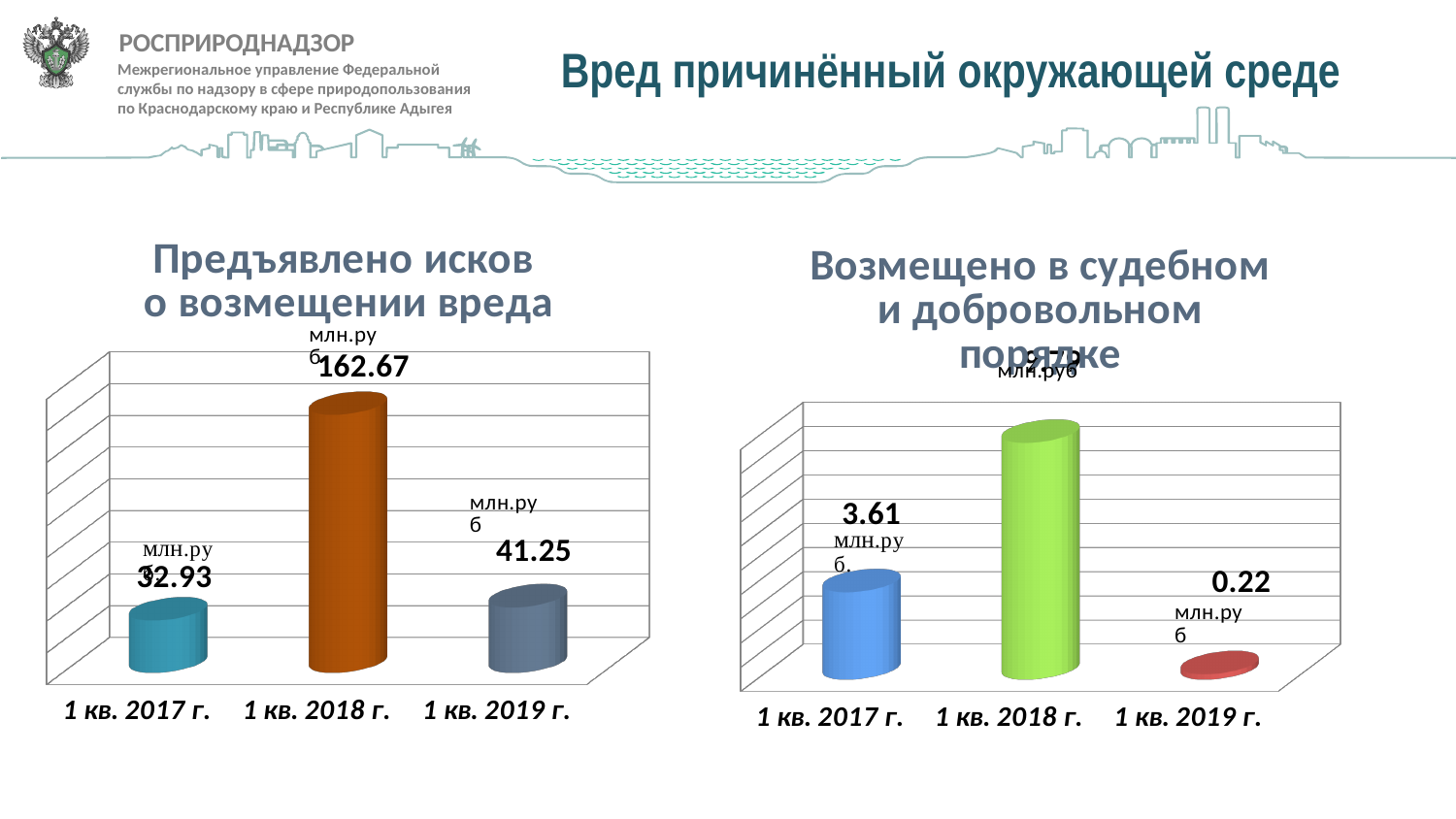
In the chart titled "Предъявлено исков о возмещении вреда", what is the value for 1 кв. 2019 г.? 41.25 In the chart titled "Возмещено в судебном и добровольном порядке", what is the value for 1 кв. 2017 г.? 3.61 In the chart titled "Предъявлено исков о возмещении вреда", which period has the lowest value? 1 кв. 2017 г. What kind of chart is the chart titled "Возмещено в судебном и добровольном порядке"? Bar chart In the chart titled "Предъявлено исков о возмещении вреда", what is the difference between the values for 1 кв. 2018 г. and 1 кв. 2019 г.? 121.42 In the chart titled "Возмещено в судебном и добровольном порядке", what is the value for 1 кв. 2019 г.? 0.22 In the chart titled "Возмещено в судебном и добровольном порядке", which period has the lowest value? 1 кв. 2019 г. In the chart titled "Предъявлено исков о возмещении вреда", what is the value for 1 кв. 2018 г.? 162.67 In the chart titled "Предъявлено исков о возмещении вреда", which is larger: the value for 1 кв. 2017 г. or 1 кв. 2019 г.? 1 кв. 2019 г. In the chart titled "Предъявлено исков о возмещении вреда", what is the value for 1 кв. 2017 г.? 32.93 In the chart titled "Предъявлено исков о возмещении вреда", which period has the highest value? 1 кв. 2018 г. How many periods are shown on the x axis of the chart titled "Предъявлено исков о возмещении вреда"? 3